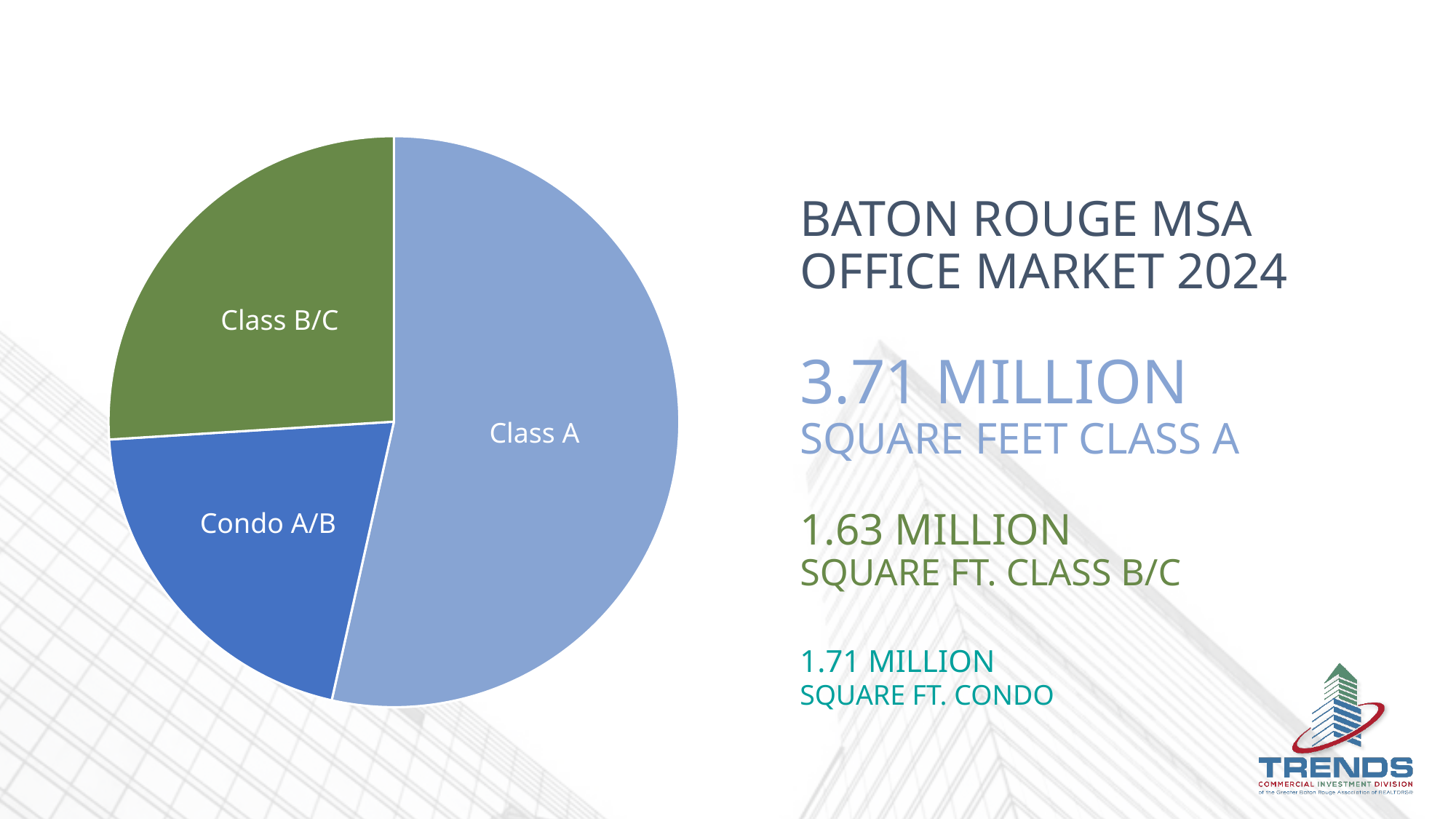
How many square feet of Class A office space does the slide report? 3.71 million What is the difference in square feet between Class A and Class B/C? 2.08 million Which is larger, the Class B/C square footage or the Condo square footage? Condo How many square feet of condo office space does the slide report? 1.71 million What kind of chart is shown on the slide? pie chart How many square feet of Class B/C office space does the slide report? 1.63 million How many slices does the pie chart have? 3 What is the title shown on the slide? Baton Rouge MSA Office Market 2024 Which slice of the pie chart is the largest? Class A What colour is the Class B/C slice of the pie chart? green Which slice of the pie chart is the smallest? Condo A/B What is the difference in square feet between Class A and Condo? 2.00 million